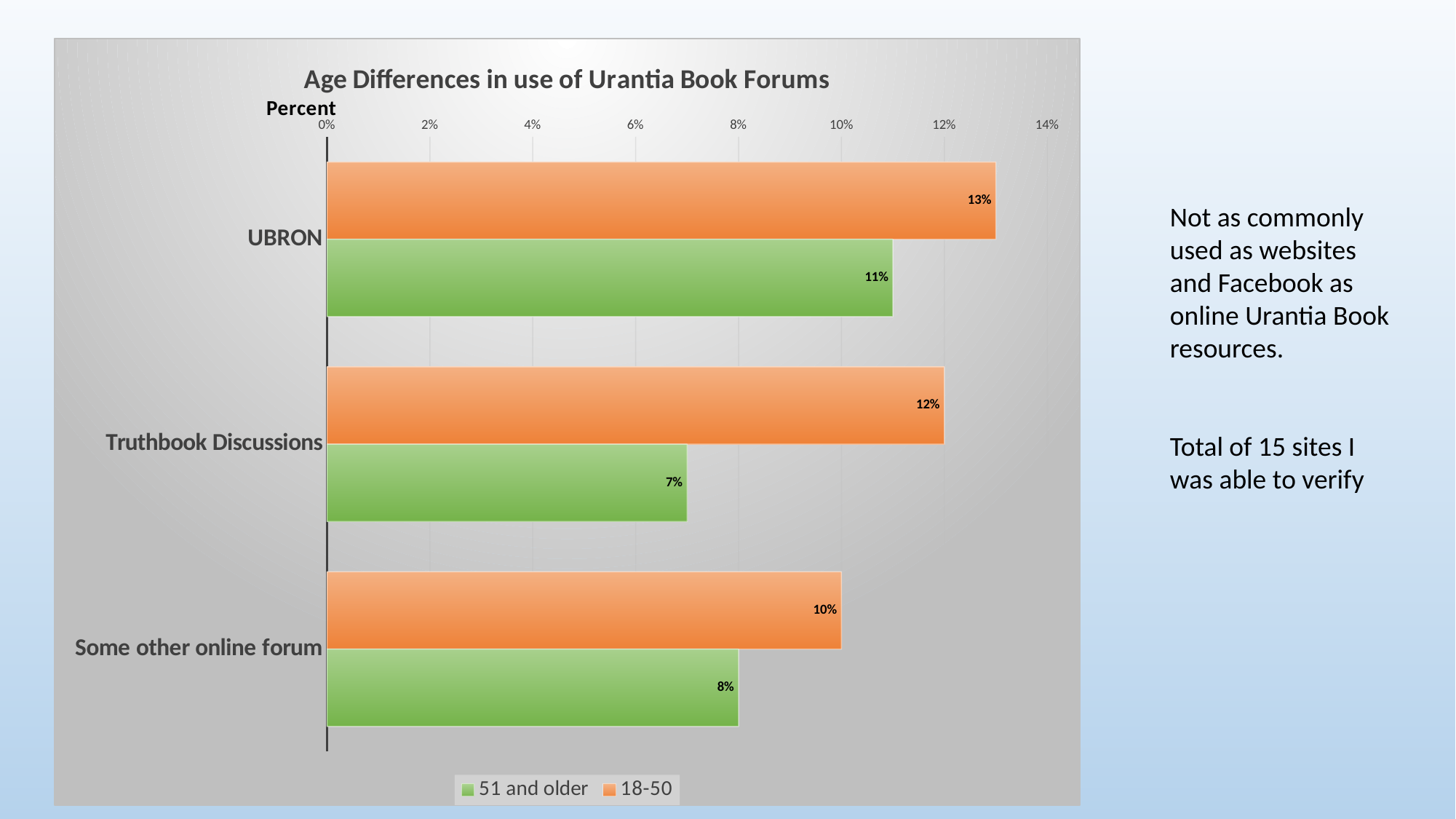
What is the title of the chart? Age Differences in use of Urantia Book Forums How many series does the legend list? 2 What is the value for the 51 and older series for UBRON? 11% What is the value for the 18-50 series for Some other online forum? 10% Which is larger for Some other online forum: the 18-50 value or the 51 and older value? 18-50 What is the value for the 18-50 series for UBRON? 13% How many categories are shown on the chart? 3 What kind of chart is shown on the slide? Bar chart What is the value for the 51 and older series for Truthbook Discussions? 7% What is the difference between the 18-50 and 51 and older values for Truthbook Discussions? 5% Which category has the lowest value for the 51 and older series? Truthbook Discussions Which category has the highest value for the 18-50 series? UBRON